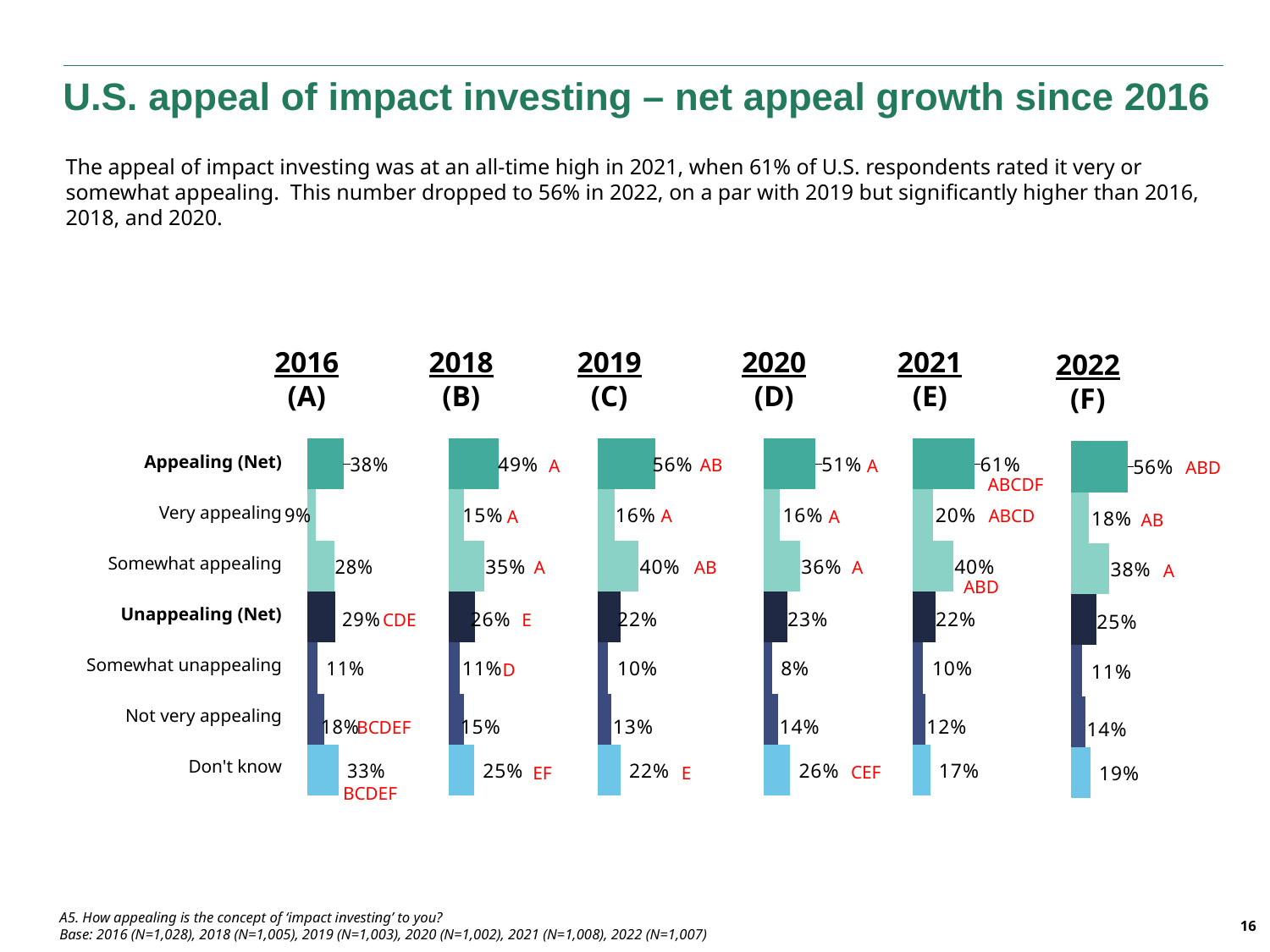
In the 2016 chart, what is the value for Don't know? 33% In the 2020 chart, what is the value for Somewhat unappealing? 8% What is the difference between the Appealing (Net) value in 2021 and in 2016? 23 percentage points In the 2019 chart, which is larger: Somewhat appealing or Don't know? Somewhat appealing What kind of chart is used for each year on this slide? Bar chart What is the title of the slide containing these charts? U.S. appeal of impact investing – net appeal growth since 2016 How many categories are shown in each year's chart? 7 In the 2022 chart, what is the value for Appealing (Net)? 56% In the 2021 chart, what is the value for Very appealing? 20% Does the Appealing (Net) value rise or fall from 2016 to 2021? Rise Across the six year charts, which year has the lowest Appealing (Net) value? 2016 Across the six year charts, which year has the highest Appealing (Net) value? 2021